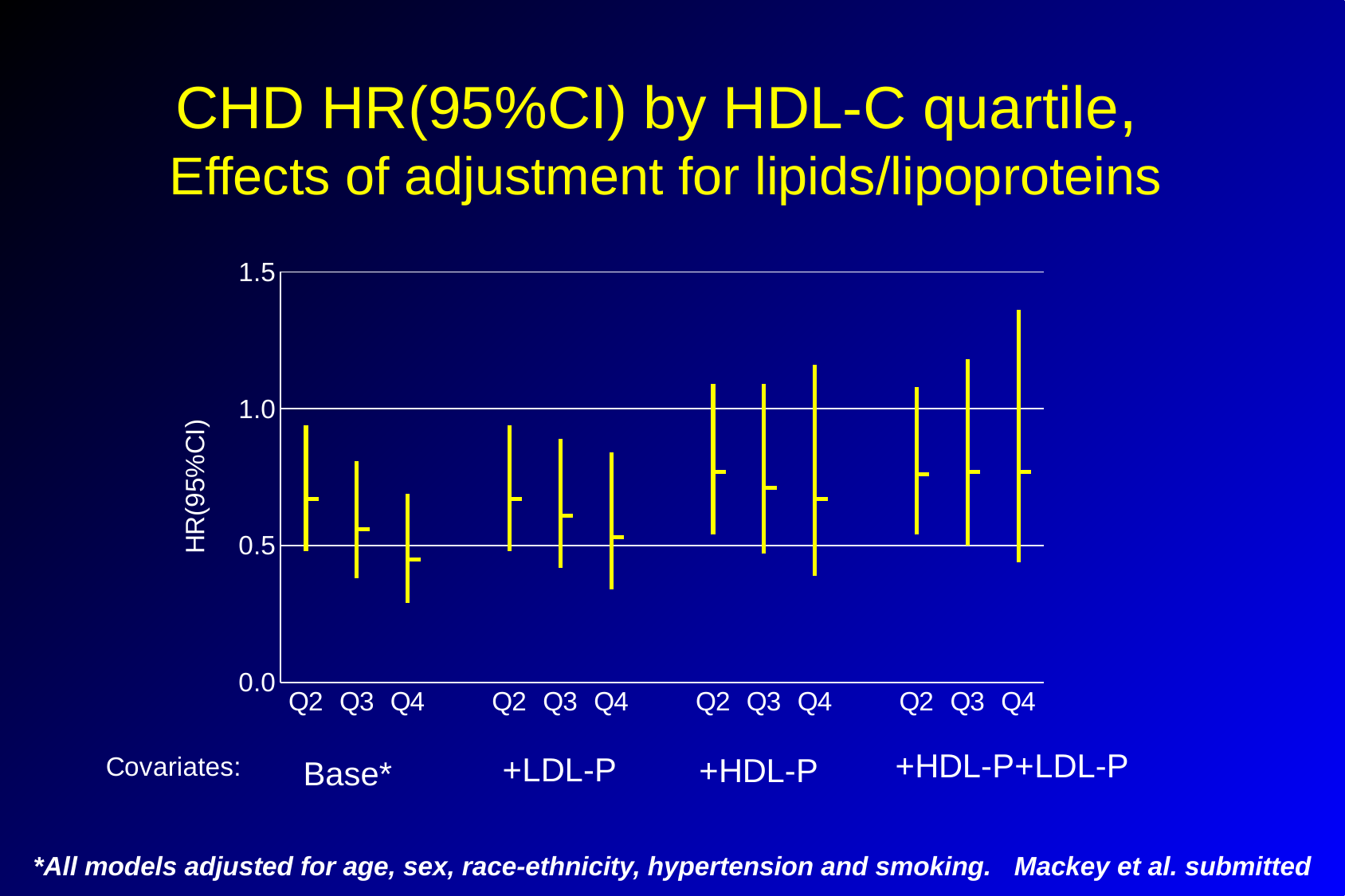
Which quartile in the Base* model has the lowest point estimate? Q4 Is the point estimate for Q4 in the +HDL-P model greater or less than 1.0? less What is the highest value shown on the y-axis of the chart? 1.5 How many covariate groups are shown along the x-axis of the chart? 4 Which point estimate is larger: Q4 in the Base* model or Q4 in the +HDL-P model? Q4 in the +HDL-P model Is the point estimate for Q4 in the Base* model greater or less than 0.5? less What is the label on the y-axis of the chart? HR(95%CI) How many HDL-C quartile estimates (points with confidence intervals) are plotted in total on the chart? 12 Is the point estimate for Q2 in the Base* model greater or less than 0.5? greater Within the Base* model, do the point estimates rise or fall from Q2 to Q4? fall